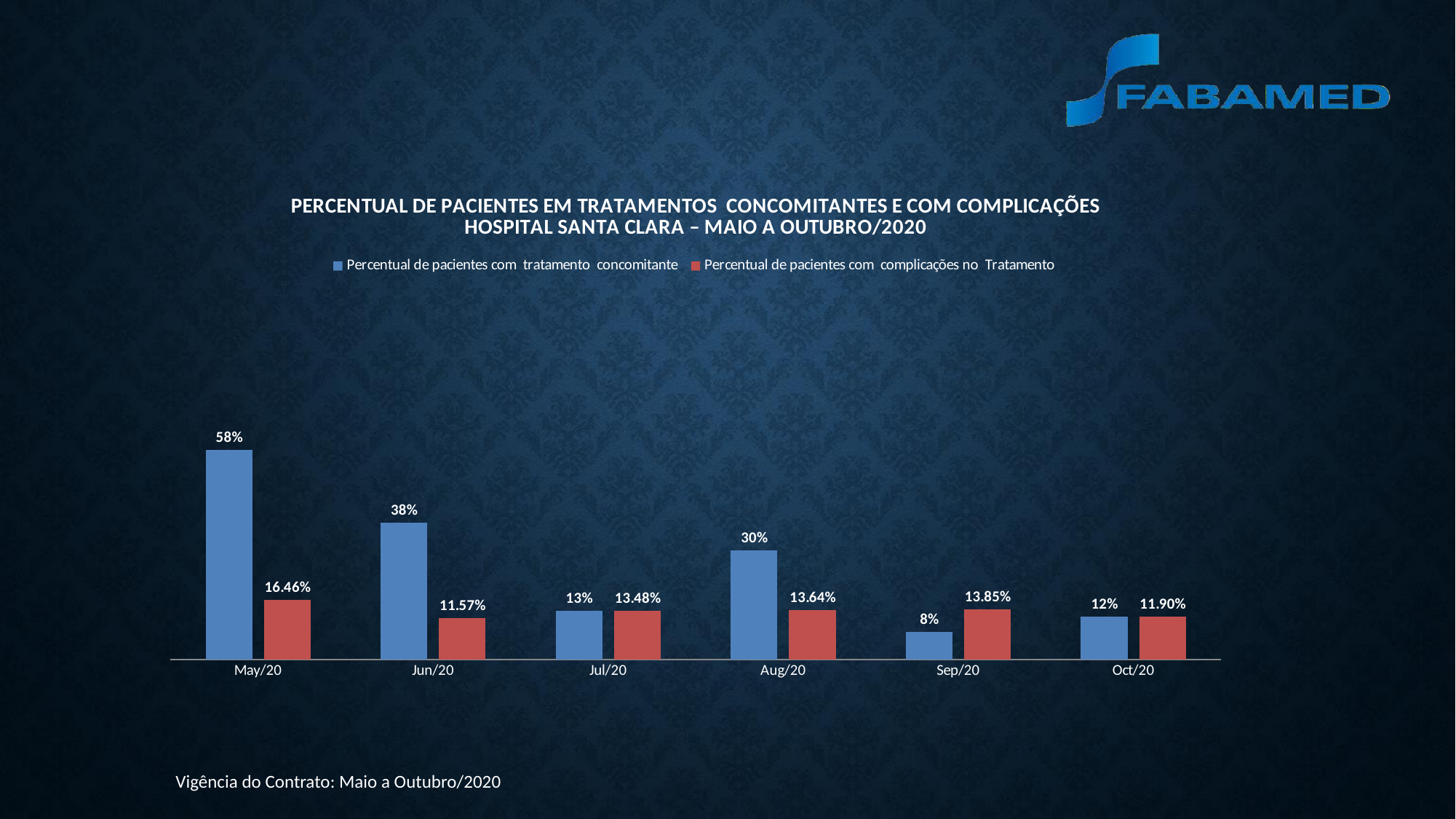
What is the percentage of patients with concomitant treatment in May/20? 58% What is the percentage of patients with complications in treatment in Sep/20? 13.85% In Aug/20, which is larger: the percentage with concomitant treatment or the percentage with complications in treatment? Percentage with concomitant treatment What is the difference between the concomitant treatment percentages for May/20 and Jun/20? 20% Which month has the lowest percentage of patients with complications in treatment? Jun/20 Which month has the lowest percentage of patients with concomitant treatment? Sep/20 Which month has the highest percentage of patients with concomitant treatment? May/20 How many months are shown on the x axis? 6 How many series does the legend list? 2 Which colour represents the percentage of patients with complications in treatment? Red What is the percentage of patients with complications in treatment in Jun/20? 11.57% What kind of chart is shown on the slide? Bar chart